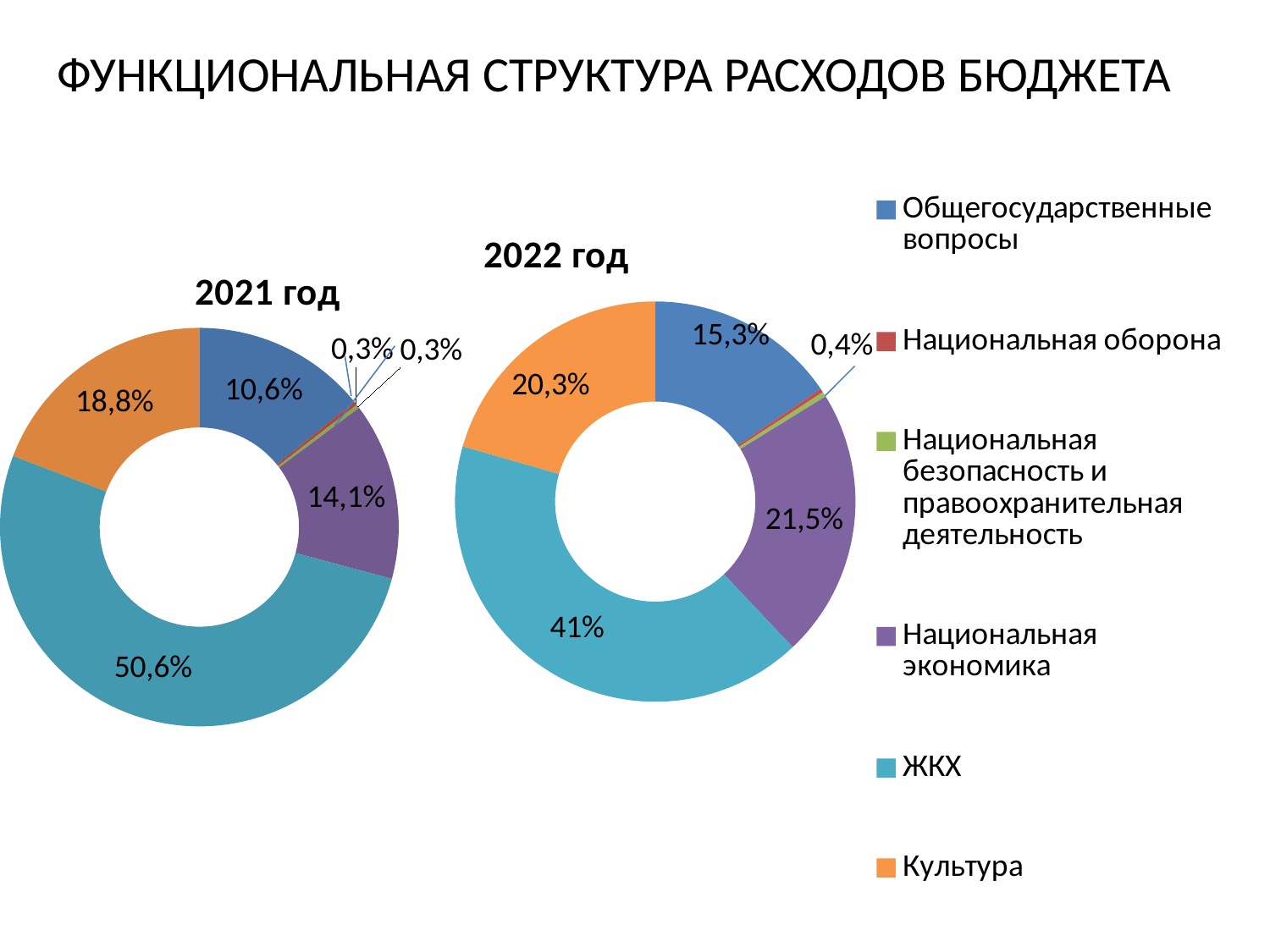
In the 2022 год chart, what share does Общегосударственные вопросы have? 15,3% In the 2021 год chart, what share does ЖКХ have? 50,6% In the 2021 год chart, what share does Культура have? 18,8% How many categories does the legend list? 6 In the 2021 год chart, which is larger: Культура or Национальная экономика? Культура What kind of chart is the 2021 год chart? Doughnut (pie) chart In the 2022 год chart, what share does ЖКХ have? 41% In the 2022 год chart, what share does Национальная экономика have? 21,5% In the 2022 год chart, what is the difference between the shares of Национальная экономика and Культура? 1,2% What is the difference between the ЖКХ share in the 2021 год chart and in the 2022 год chart? 9,6% In the 2022 год chart, which category has the largest share? ЖКХ In the 2021 год chart, which category has the largest share? ЖКХ